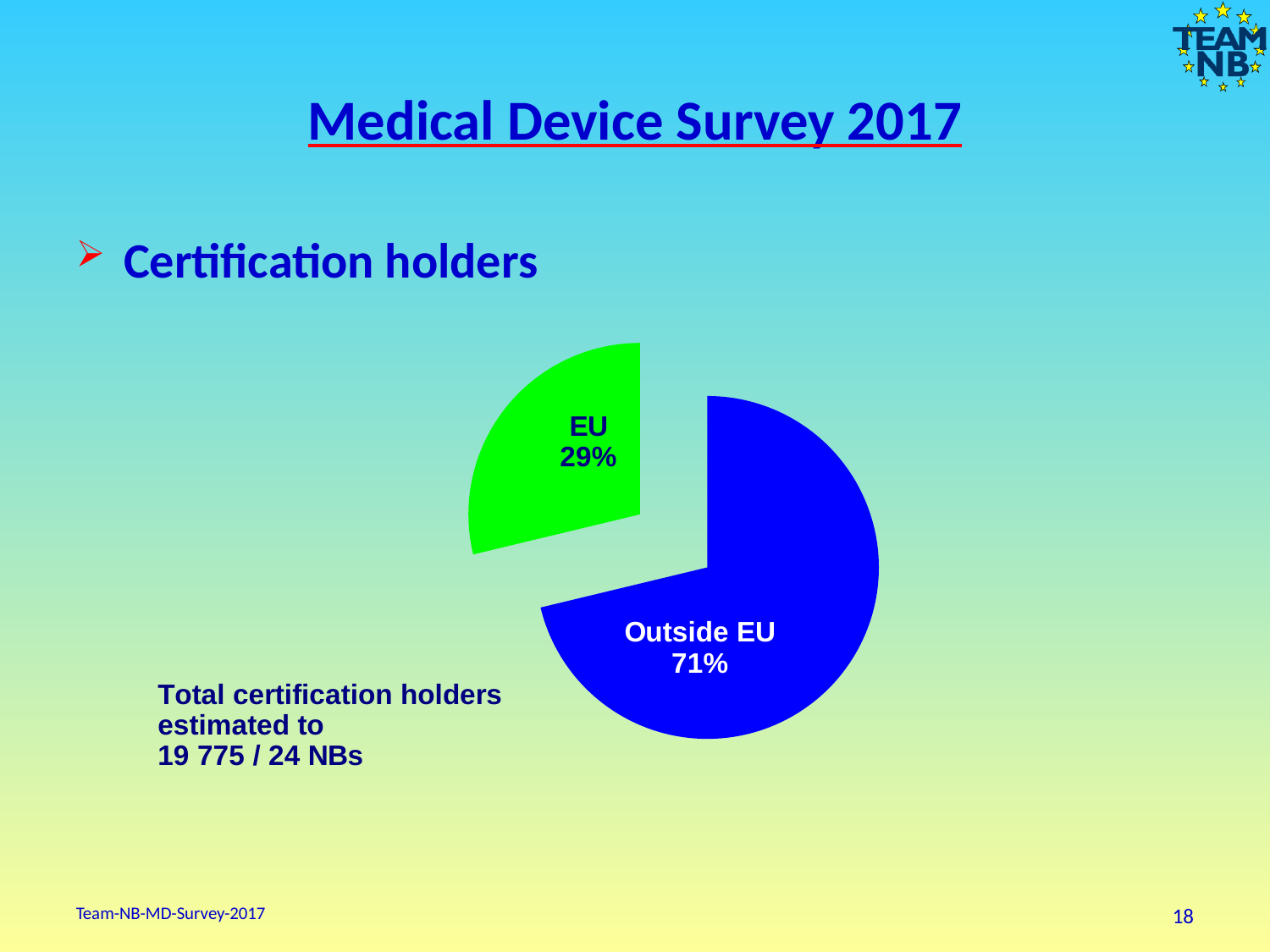
Is the share for EU greater or less than 50%? less Is the share for Outside EU greater or less than 50%? greater How many slices does the pie chart have? 2 What kind of chart is shown on the slide? pie chart Which slice of the pie is the smallest? EU Which is larger, the EU slice or the Outside EU slice? Outside EU What is the difference in percentage points between the Outside EU and EU slices? 42 Which slice of the pie is the largest? Outside EU What colour is the EU slice? green What share of certification holders is from outside the EU? 71% What share of certification holders is from the EU? 29% What colour is the Outside EU slice? blue